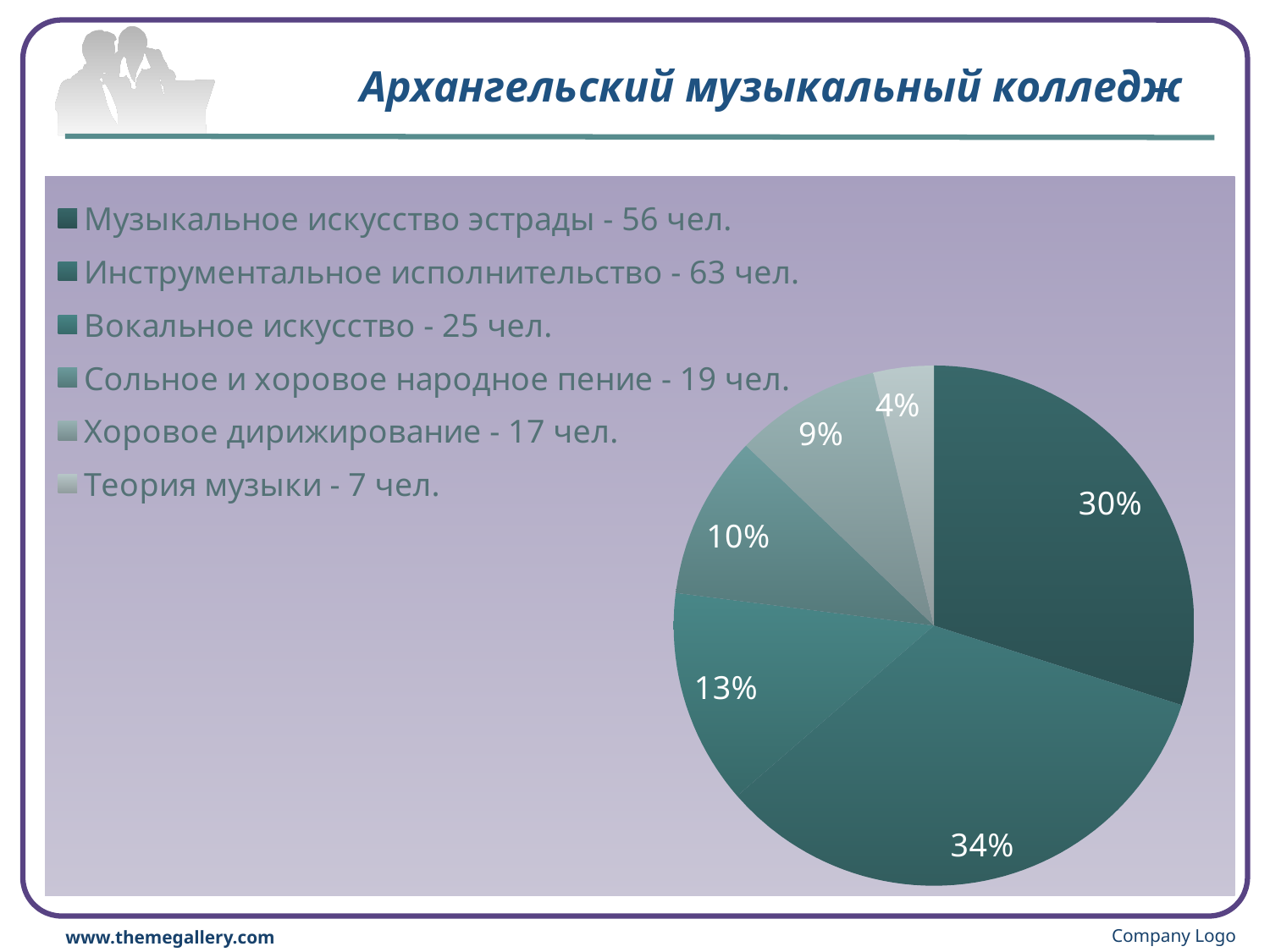
What share of the pie does "Инструментальное исполнительство" take? 34% What kind of chart is shown on the slide? pie chart What share of the pie does "Вокальное искусство" take? 13% Which category has the smallest slice of the pie? Теория музыки How many people are listed in the legend for "Хоровое дирижирование"? 17 чел. What is the difference in percentage points between the "Инструментальное исполнительство" slice and the "Музыкальное искусство эстрады" slice? 4 How many slices does the pie chart have? 6 What share of the pie does "Музыкальное искусство эстрады" take? 30% Which category has the largest slice of the pie? Инструментальное исполнительство How many entries does the legend list? 6 Which slice is larger: "Сольное и хоровое народное пение" or "Хоровое дирижирование"? Сольное и хоровое народное пение